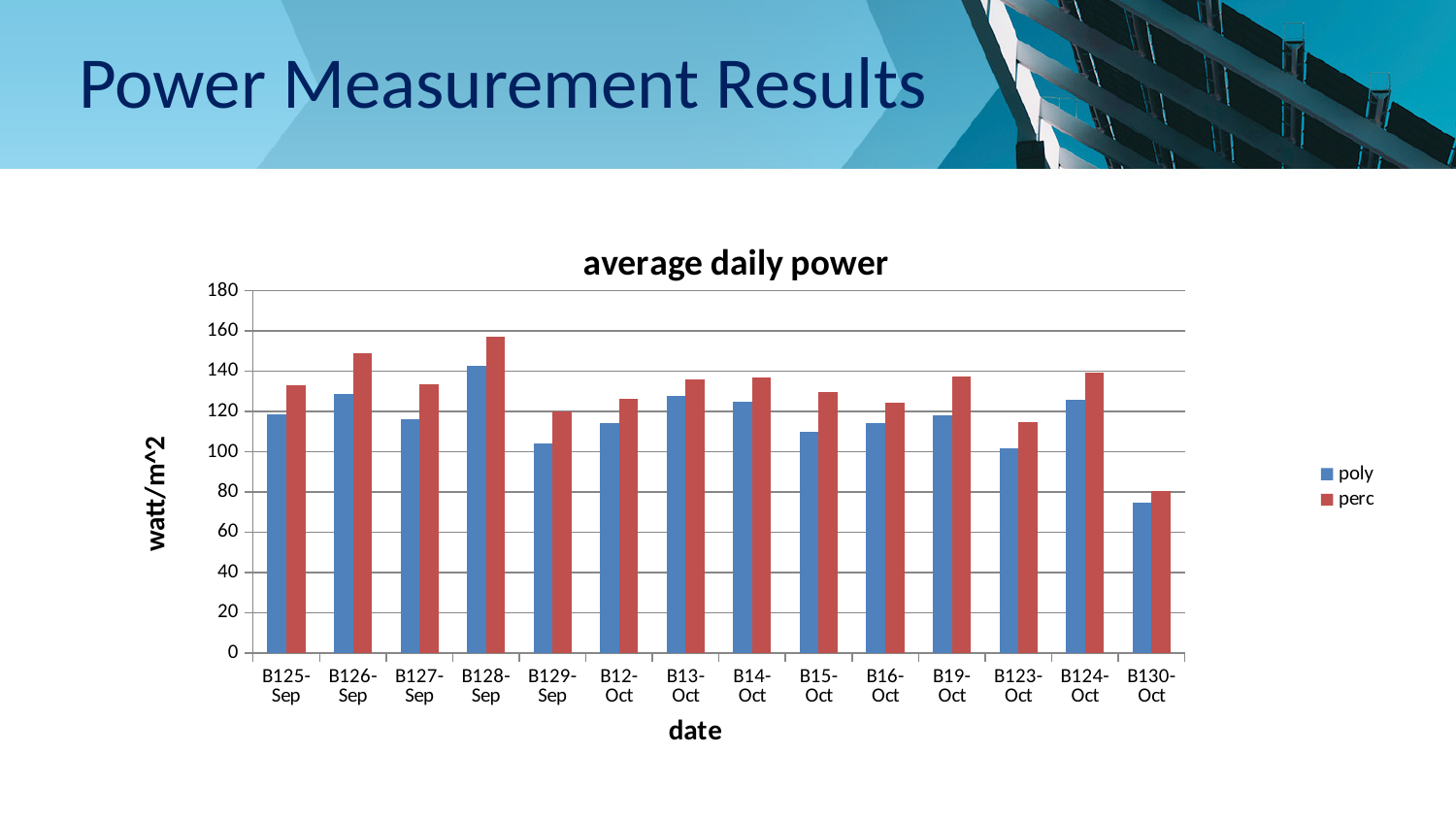
Is the perc value for B126-Sep greater or less than 140? greater How many series does the legend list? 2 Is the poly value for B15-Oct greater or less than 120? less Is the perc value for B128-Sep greater or less than 140? greater Which date has the lowest value for the poly series? B130-Oct Which series is shown in blue? poly What is the title of the chart? average daily power How many date categories are shown on the x axis? 14 Which date has the highest value for the perc series? B128-Sep What kind of chart is shown on the slide? bar chart For B14-Oct, which series has the larger value, poly or perc? perc